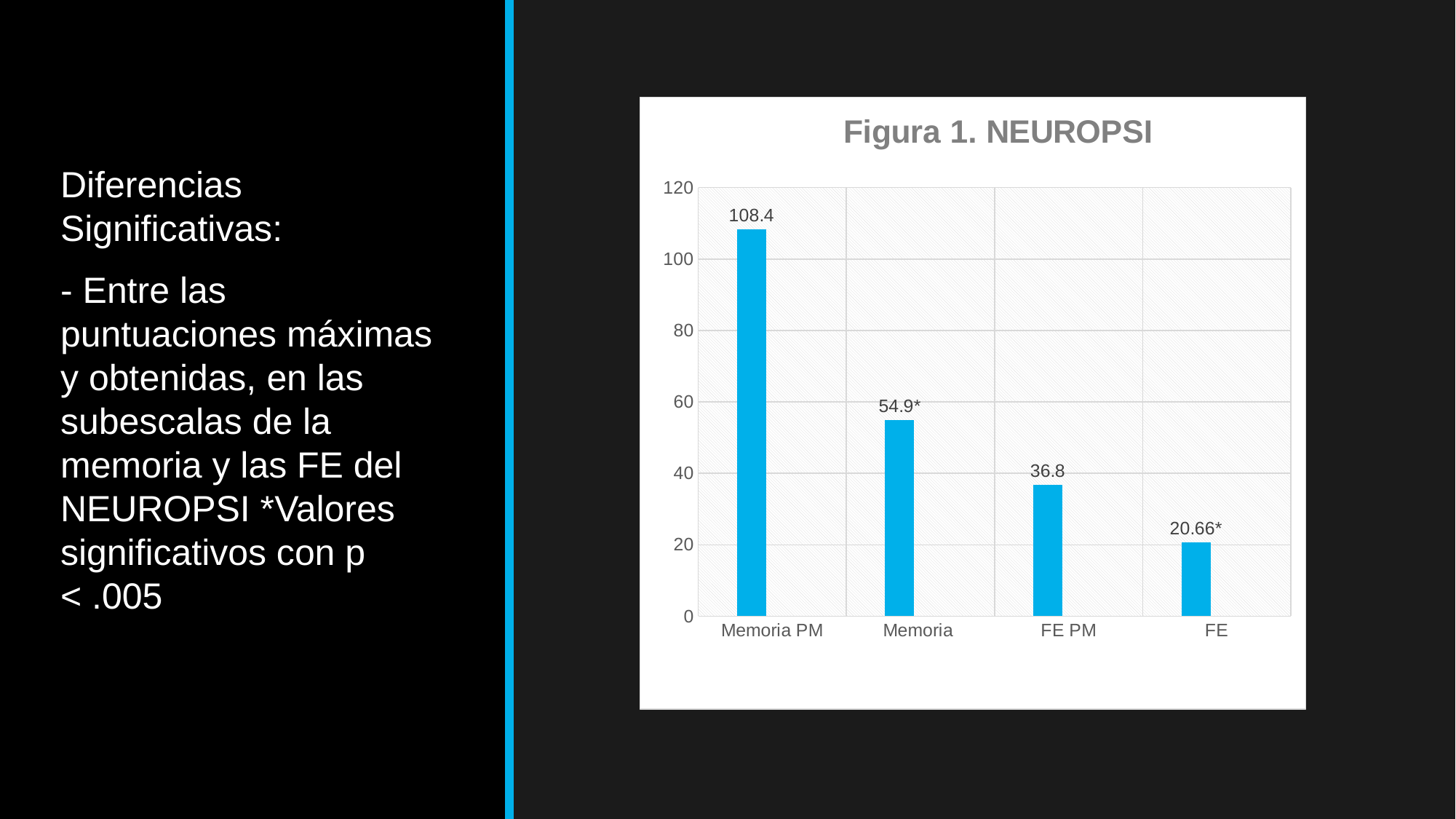
What is the difference between the values for Memoria PM and Memoria? 53.5 What is the value shown for Memoria? 54.9* What is the difference between the values for FE PM and FE? 16.14 Which category has the lowest value? FE What is the title of the chart? Figura 1. NEUROPSI What is the value for Memoria PM? 108.4 Which category has the highest value? Memoria PM What kind of chart is this? Bar chart What is the value for FE PM? 36.8 Which is larger, the value for Memoria or the value for FE PM? Memoria How many categories are shown on the x axis? 4 What is the value shown for FE? 20.66*